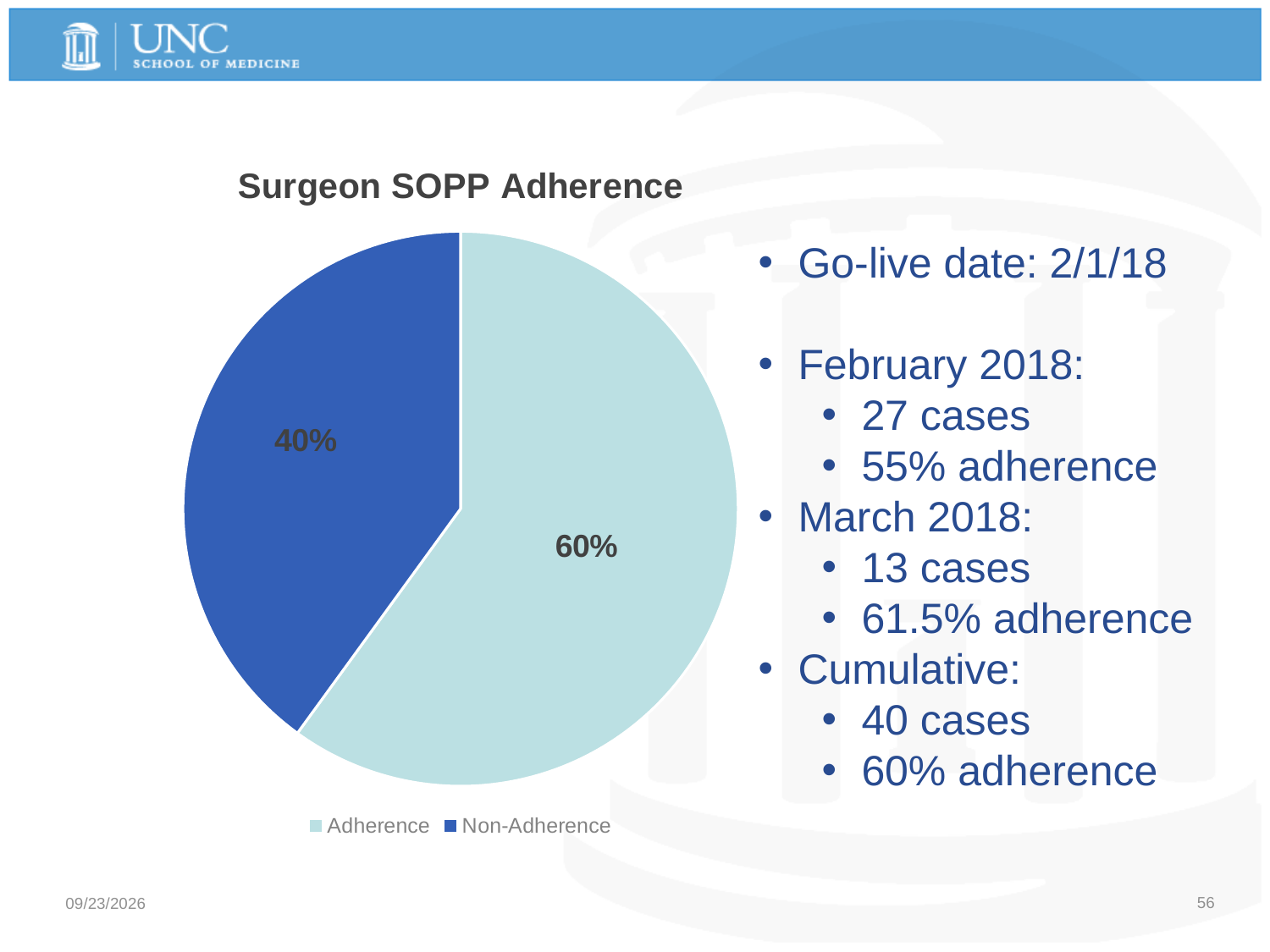
Which slice is the largest? Adherence How many slices does the pie chart have? 2 How many entries does the legend list? 2 What is the title of the chart? Surgeon SOPP Adherence What share of the pie is Adherence? 60% Which slice is the smallest? Non-Adherence Which is larger, Adherence or Non-Adherence? Adherence What share of the pie is Non-Adherence? 40% What kind of chart is shown on the slide? pie chart What colour is the Non-Adherence slice? dark blue What is the difference in percentage points between Adherence and Non-Adherence? 20%